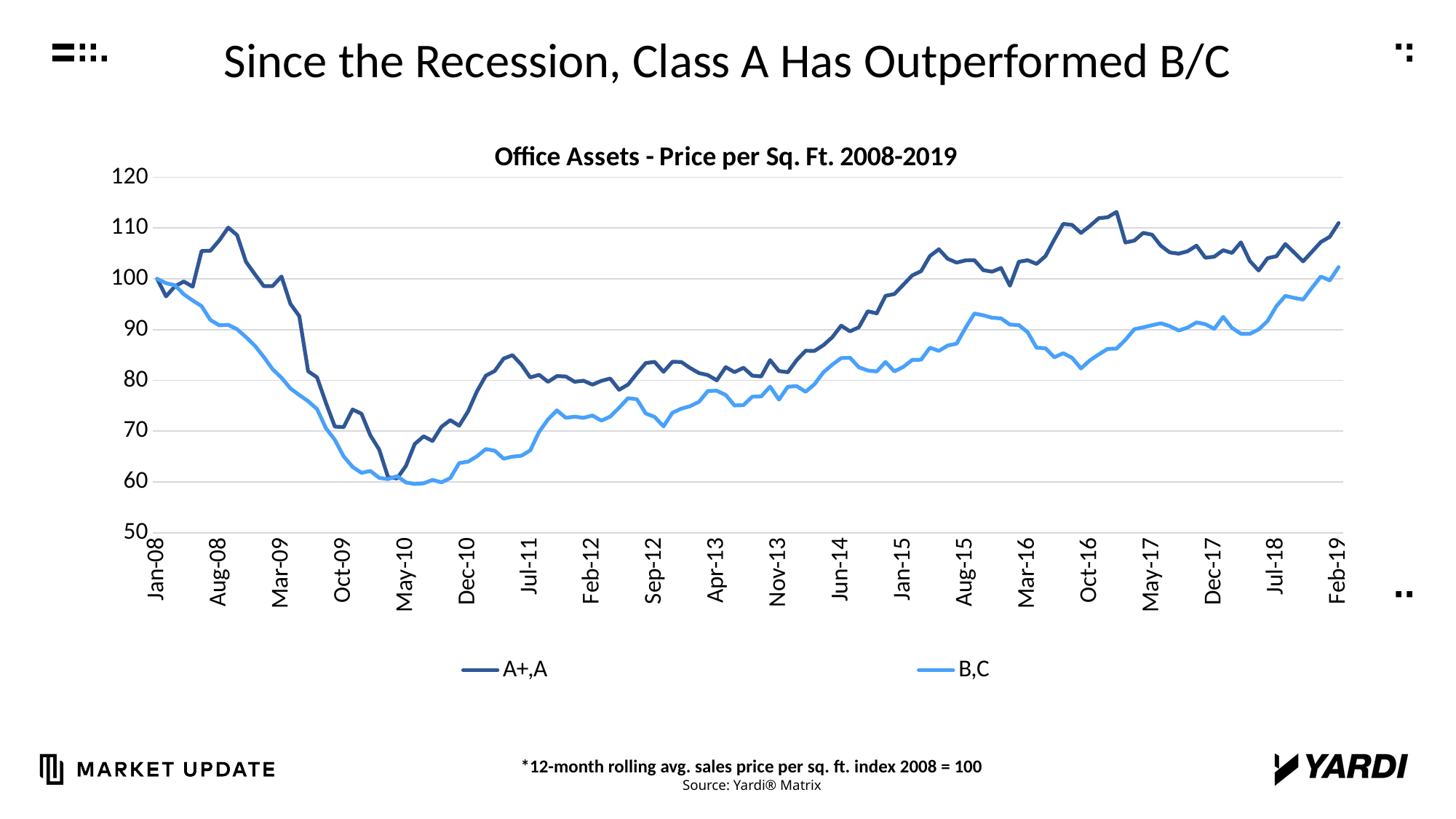
How many series does the legend list? 2 What kind of chart is shown on the slide? line chart Is the value for B,C at Feb-19 greater or less than 90? greater Is the value for B,C at Oct-16 greater or less than 90? less How many labels are shown on the x axis? 20 Is the value for A+,A at May-10 greater or less than 70? less Does the B,C series rise or fall between Jan-08 and May-10? fall At Feb-19, which series has the higher value, A+,A or B,C? A+,A What is the title of the chart? Office Assets - Price per Sq. Ft. 2008-2019 Which series is drawn in the lighter blue line? B,C